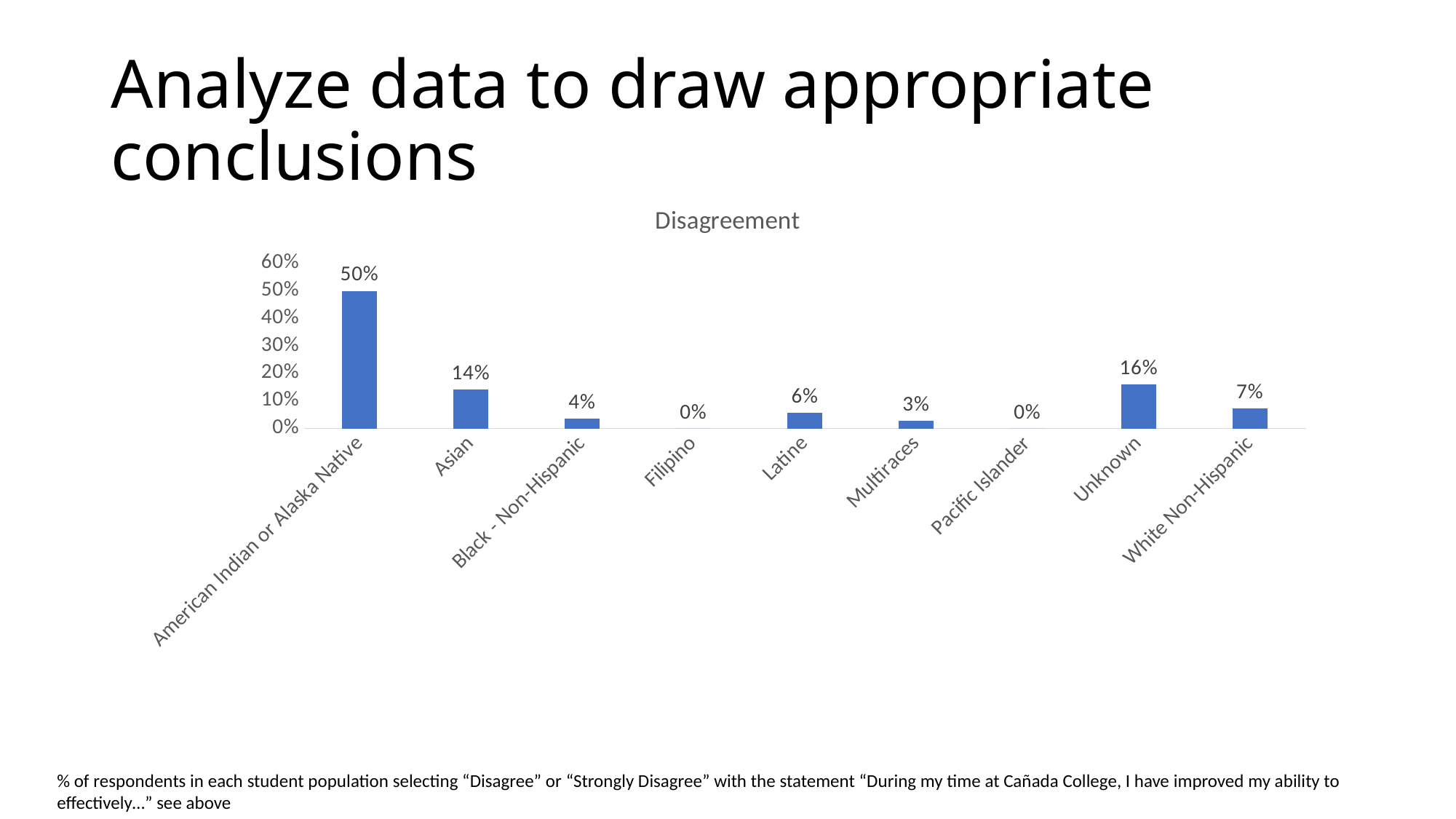
Which is larger, the value for Asian or the value for Unknown? Unknown What is the value for Latine? 6% What kind of chart is shown on the slide? Bar chart How many categories are shown on the x axis? 9 What is the title of the chart? Disagreement Which category has the highest value? American Indian or Alaska Native What is the difference between the values for Asian and Black - Non-Hispanic? 10% What is the value for Unknown? 16% Which is larger, the value for Latine or the value for Multiraces? Latine What is the value for American Indian or Alaska Native? 50% What is the value for White Non-Hispanic? 7% What is the difference between the values for Unknown and White Non-Hispanic? 9%